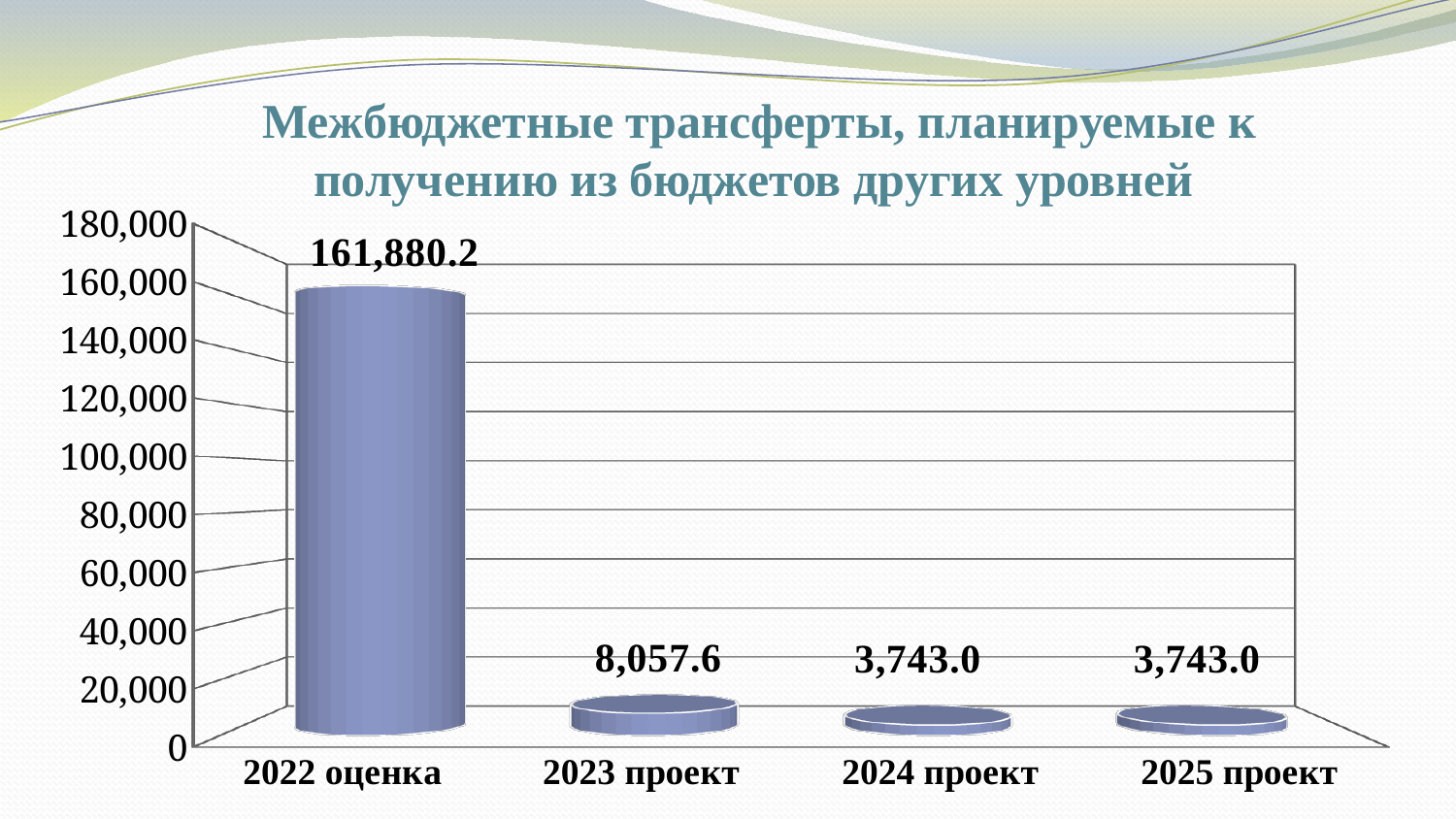
What is the difference between the values for 2022 оценка and 2023 проект? 153,822.6 What is the value for 2024 проект? 3,743.0 Which category has the highest value? 2022 оценка What is the title of the chart? Межбюджетные трансферты, планируемые к получению из бюджетов других уровней What is the value for 2022 оценка? 161,880.2 Do the values rise or fall from 2022 оценка to 2024 проект? fall What kind of chart is shown on the slide? bar chart What is the value for 2023 проект? 8,057.6 How many categories are shown on the x axis? 4 What is the difference between the values for 2023 проект and 2024 проект? 4,314.6 Is the value for 2022 оценка greater or less than 160,000? greater Which is larger, the value for 2023 проект or the value for 2025 проект? 2023 проект